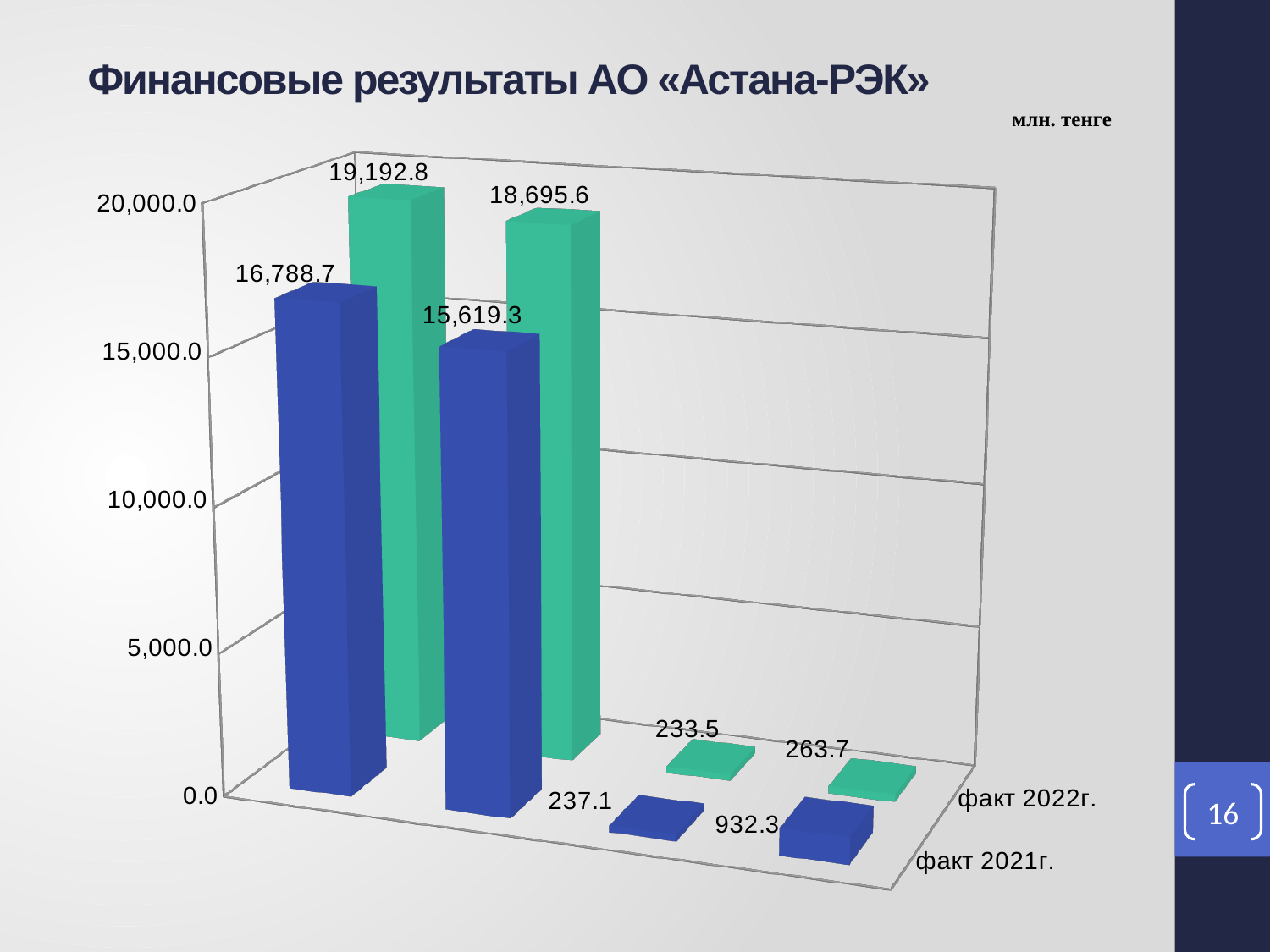
What is the value of the leftmost bar in the series факт 2021г.? 16,788.7 What unit is indicated for the values in the chart? млн. тенге What is the difference between the leftmost bars of факт 2022г. (19,192.8) and факт 2021г. (16,788.7)? 2,404.1 What is the value of the rightmost bar in the series факт 2021г.? 932.3 Which is larger: the rightmost bar of факт 2021г. (932.3) or the rightmost bar of факт 2022г. (263.7)? факт 2021г. (932.3) What kind of chart is shown on the slide? bar chart What is the value of the second bar from the left in the series факт 2022г.? 18,695.6 What is the value of the leftmost bar in the series факт 2022г.? 19,192.8 Which bar has the highest value in the chart? 19,192.8 (факт 2022г.) What is the title of the chart on the slide? Финансовые результаты АО «Астана-РЭК» How many series are shown in the chart? 2 How many bars are plotted for the series факт 2021г.? 4